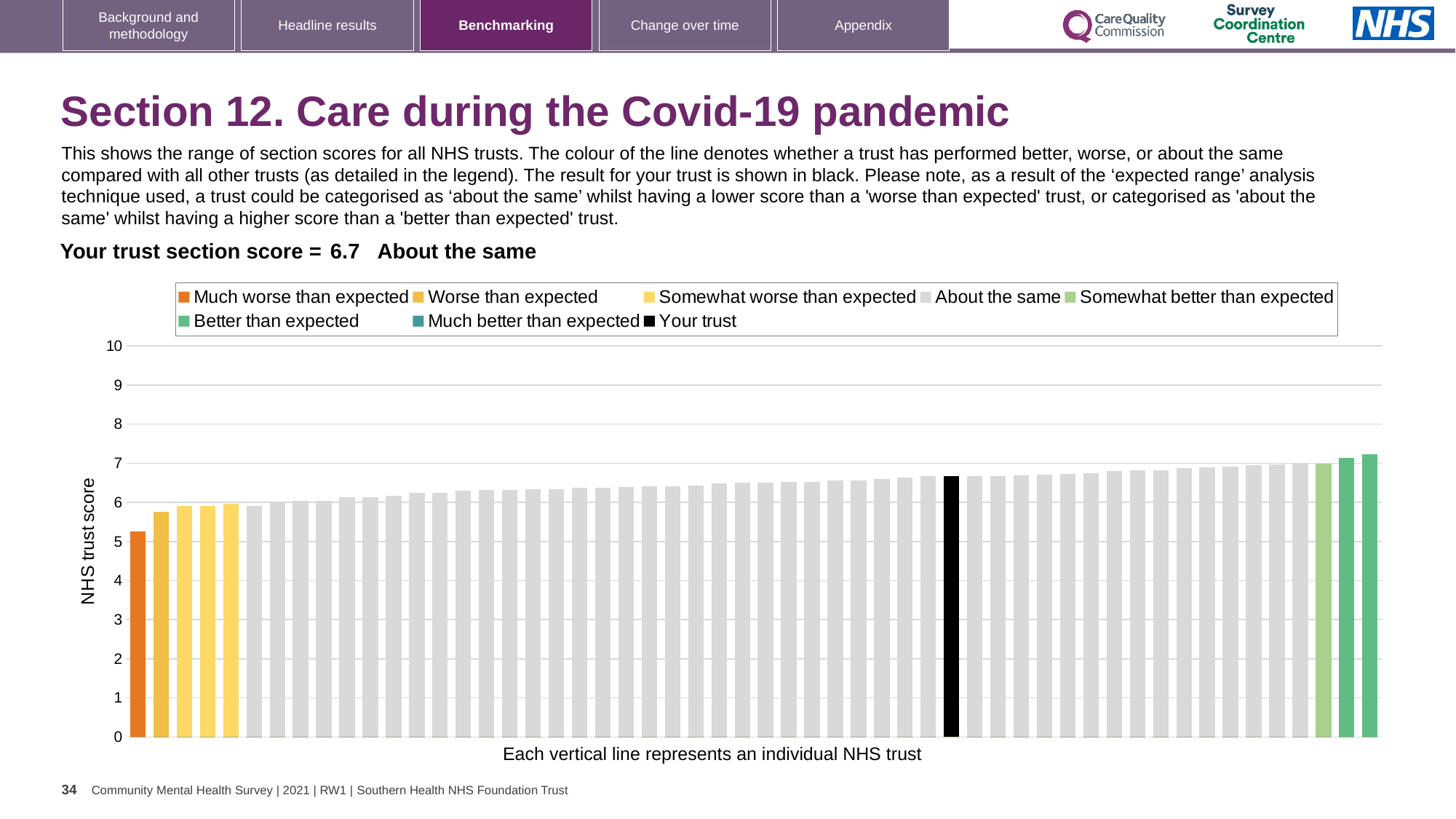
What is the section score for your trust shown on the slide? 6.7 Is the value of the black 'Your trust' bar greater or less than 6? greater What is the label on the vertical axis of the chart? NHS trust score Do the bar values rise or fall from left to right along the x axis? Rise How many entries does the chart legend list? 8 How is your trust categorised compared with other trusts, according to the text above the chart? About the same Is the value of the highest bar (the rightmost green bar) greater or less than 7? greater What colour is used for the 'Your trust' bar in the chart? Black Is the value of the lowest bar (the leftmost orange bar) greater or less than 6? less Which legend category does the highest bar on the chart belong to? Better than expected What kind of chart is shown on the slide? Bar chart Which legend category does the lowest bar on the chart belong to? Much worse than expected